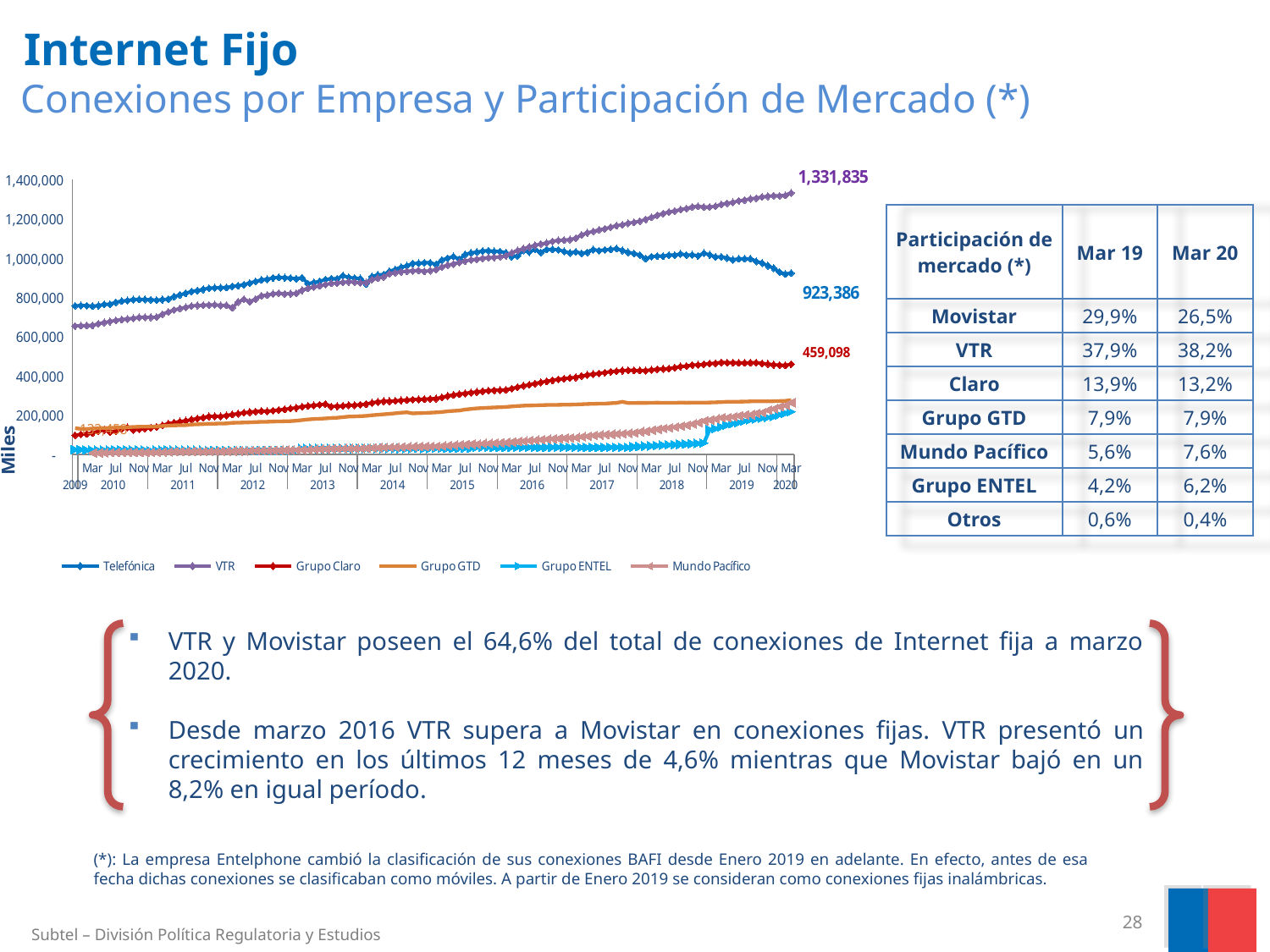
What is the value labelled for Grupo Claro at the end of the chart (Mar 2020)? 459,098 Which series has the highest value at the end of the chart (Mar 2020)? VTR Does the VTR series rise or fall from 2009 to 2020? rises What type of chart is shown on the slide? line chart Is the value for Grupo GTD at Mar 2020 greater or less than 400,000? less What is the value labelled for Telefónica at the end of the chart (Mar 2020)? 923,386 What is the difference between the labelled end values of VTR and Telefónica? 408,449 What is the value labelled for VTR at the end of the chart (Mar 2020)? 1,331,835 What is the difference between the labelled end values of Telefónica and Grupo Claro? 464,288 How many series does the chart legend list? 6 What is the label on the vertical axis of the chart? Miles